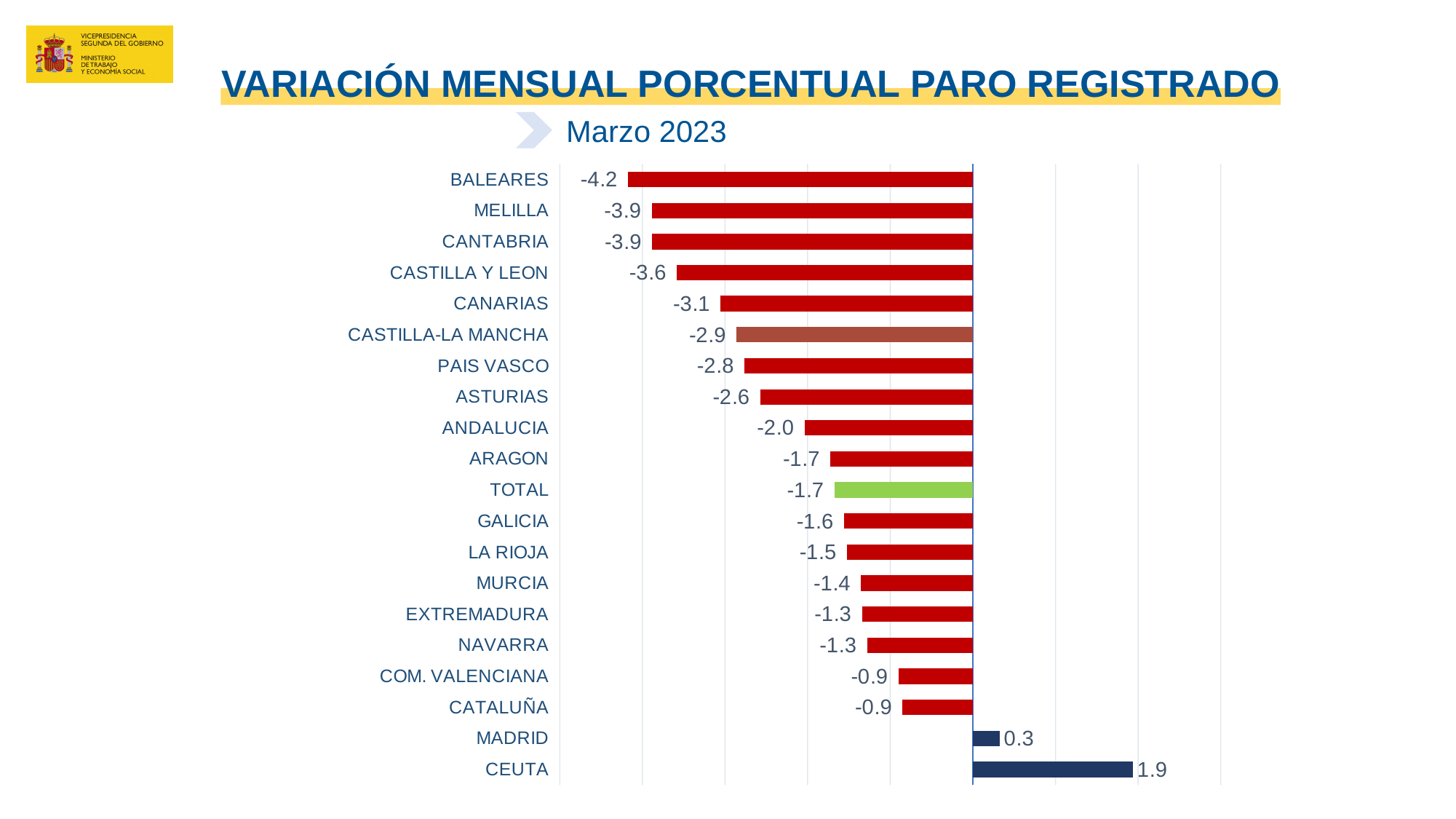
Which category has the highest value? CEUTA How many categories are shown in the chart? 20 What is the value for CEUTA? 1.9 What is the value for CASTILLA-LA MANCHA? -2.9 What is the difference between the values for BALEARES and CANARIAS? 1.1 What is the value for BALEARES? -4.2 What is the difference between the values for CEUTA and MADRID? 1.6 What is the title of the chart? VARIACIÓN MENSUAL PORCENTUAL PARO REGISTRADO Which category has the lowest value? BALEARES What is the value for TOTAL? -1.7 What kind of chart is shown on the slide? bar chart Which has the larger value, ANDALUCIA or ASTURIAS? ANDALUCIA